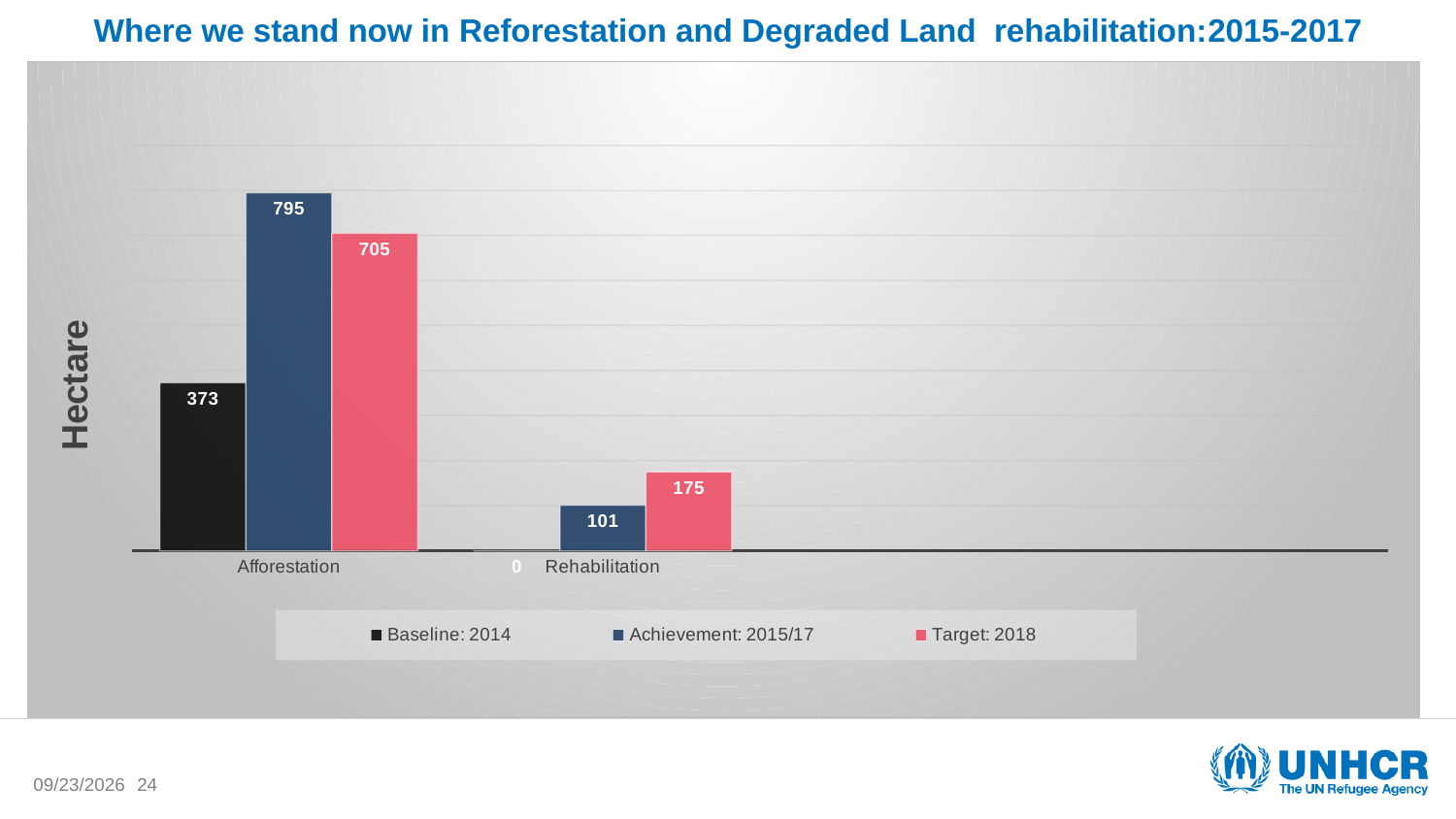
How many series does the legend list? 3 What is the Target: 2018 value for Rehabilitation? 175 What is the Baseline: 2014 value for Rehabilitation? 0 Which series has the lowest value for Rehabilitation? Baseline: 2014 What is the difference between the Target: 2018 and Achievement: 2015/17 values for Rehabilitation? 74 What kind of chart is shown on the slide? Bar chart Which series has the highest value for Afforestation? Achievement: 2015/17 What is the Baseline: 2014 value for Afforestation? 373 Which is larger: the Achievement: 2015/17 value for Afforestation or for Rehabilitation? Afforestation How many categories are shown on the x axis? 2 What is the difference between the Achievement: 2015/17 and Target: 2018 values for Afforestation? 90 What is the Achievement: 2015/17 value for Afforestation? 795